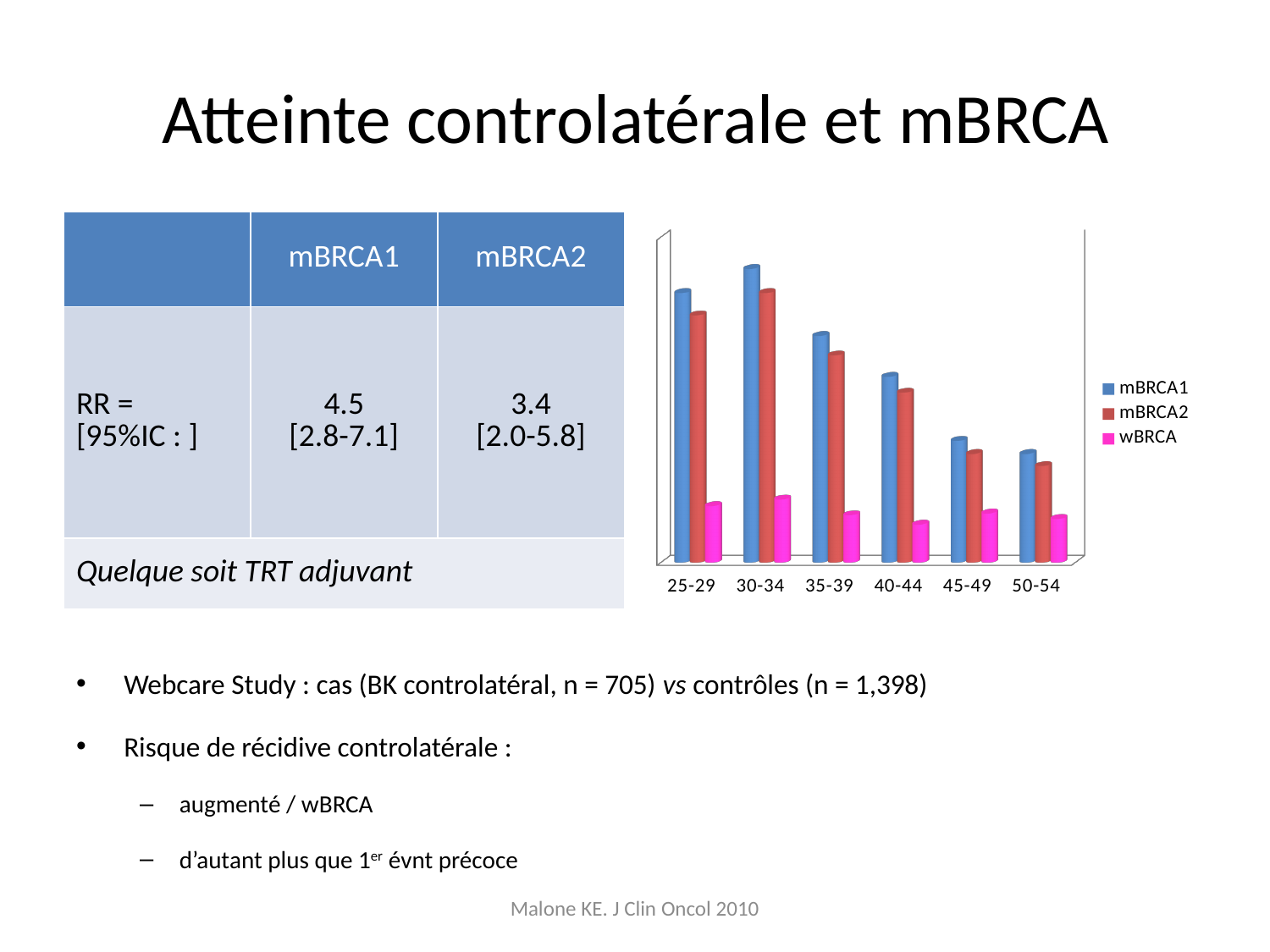
What colour are the wBRCA bars in the chart? pink How many series does the legend of the bar chart list? 3 For the 25-29 age group, which is larger: the mBRCA1 bar or the wBRCA bar? mBRCA1 For the 40-44 age group, which is larger: the mBRCA2 bar or the wBRCA bar? mBRCA2 In which age group is the mBRCA2 bar the tallest? 30-34 How many age-group categories are shown on the x axis of the bar chart? 6 For the 35-39 age group, which is larger: the mBRCA1 bar or the mBRCA2 bar? mBRCA1 Do the mBRCA1 bars rise or fall from the 30-34 age group to the 50-54 age group? fall What kind of chart is shown on the right of the slide? bar chart Which series are listed in the legend of the bar chart? mBRCA1, mBRCA2, wBRCA In which age group is the mBRCA1 bar the tallest? 30-34 Which age group is the first category on the x axis of the bar chart? 25-29